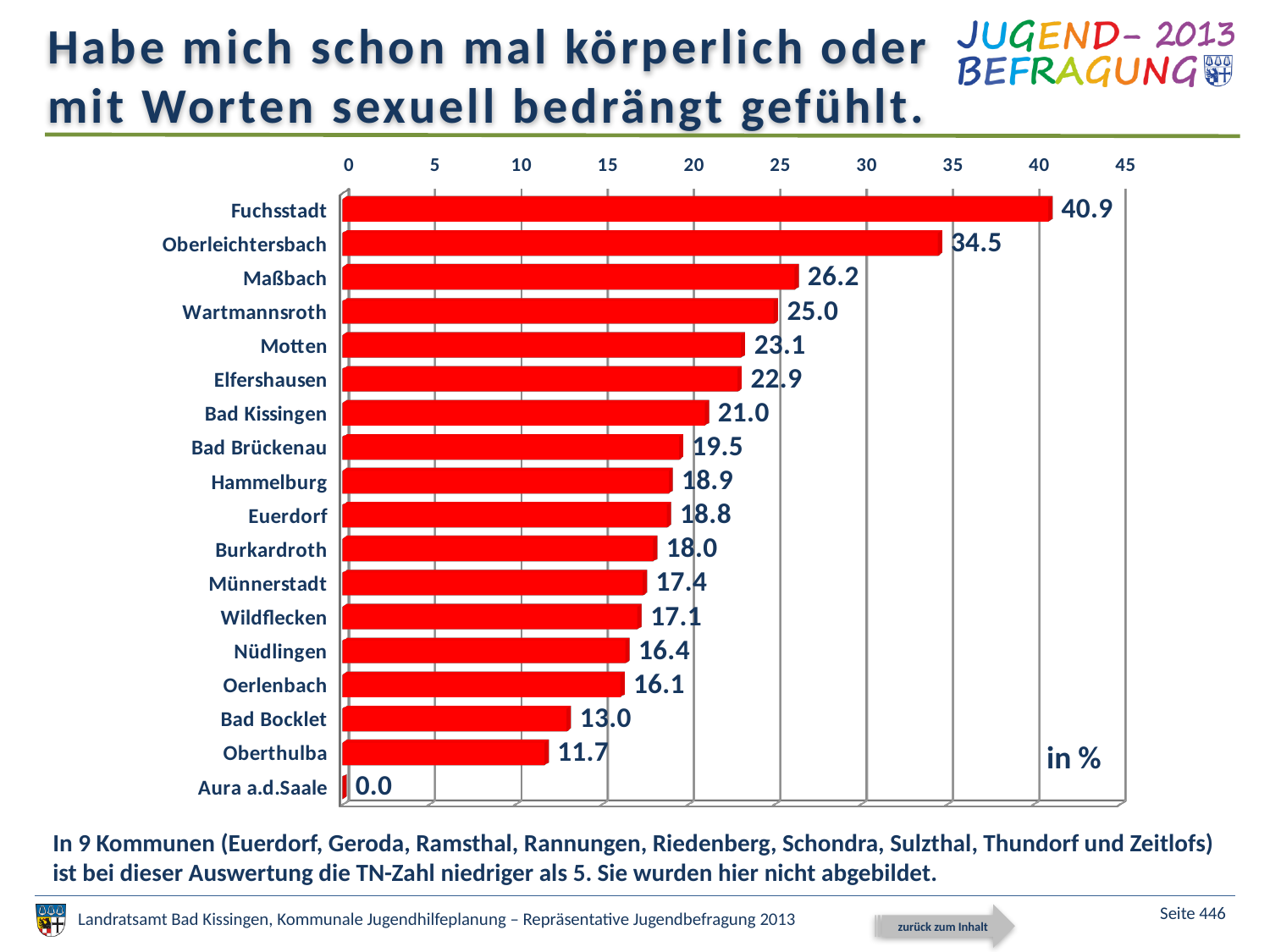
What is the value for Fuchsstadt? 40.9 What unit are the values given in, according to the label inside the chart? in % Which municipality has the highest value? Fuchsstadt Which municipality has the lowest value? Aura a.d.Saale Is the value for Oberleichtersbach greater or less than 30? greater What is the value for Bad Kissingen? 21.0 What is the value for Oberthulba? 11.7 What is the difference between the values for Fuchsstadt and Oberleichtersbach? 6.4 What is the difference between the values for Maßbach and Bad Bocklet? 13.2 How many municipalities are shown in the chart? 18 Which has a larger value, Wartmannsroth or Hammelburg? Wartmannsroth What kind of chart is shown on the slide? bar chart